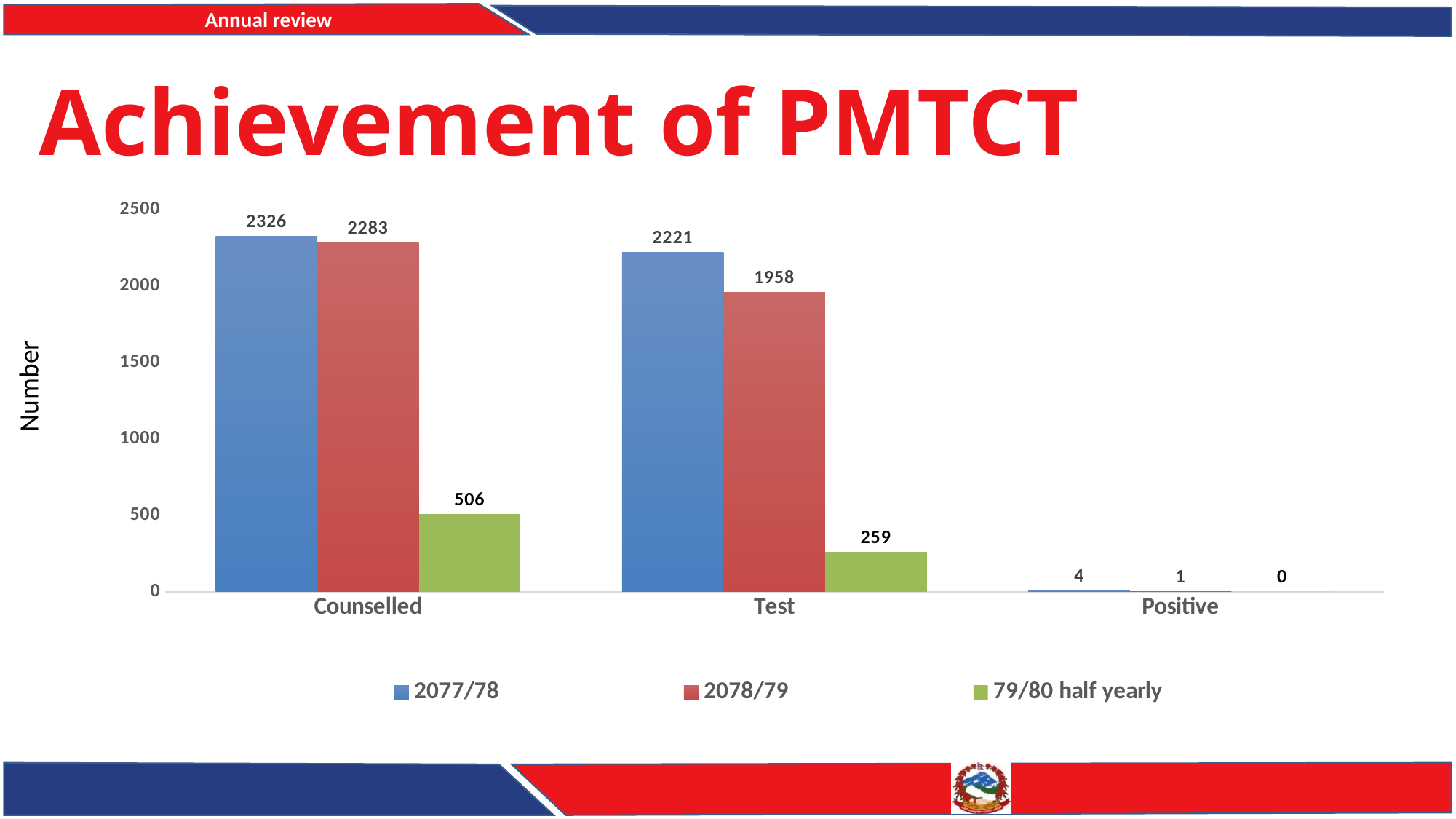
What is the label of the y axis? Number How many categories are shown on the x axis? 3 What is the difference between the 2077/78 and 2078/79 values for Test? 263 What is the value for Positive in the 79/80 half yearly series? 0 Which is larger for Counselled: the 2077/78 value or the 2078/79 value? 2077/78 Which category has the highest value in the 2077/78 series? Counselled Which category has the lowest value in the 2078/79 series? Positive What is the value for Counselled in the 79/80 half yearly series? 506 What is the value for Test in the 2078/79 series? 1958 What is the value for Counselled in the 2077/78 series? 2326 What kind of chart is shown on the slide? Bar chart How many series does the legend list? 3